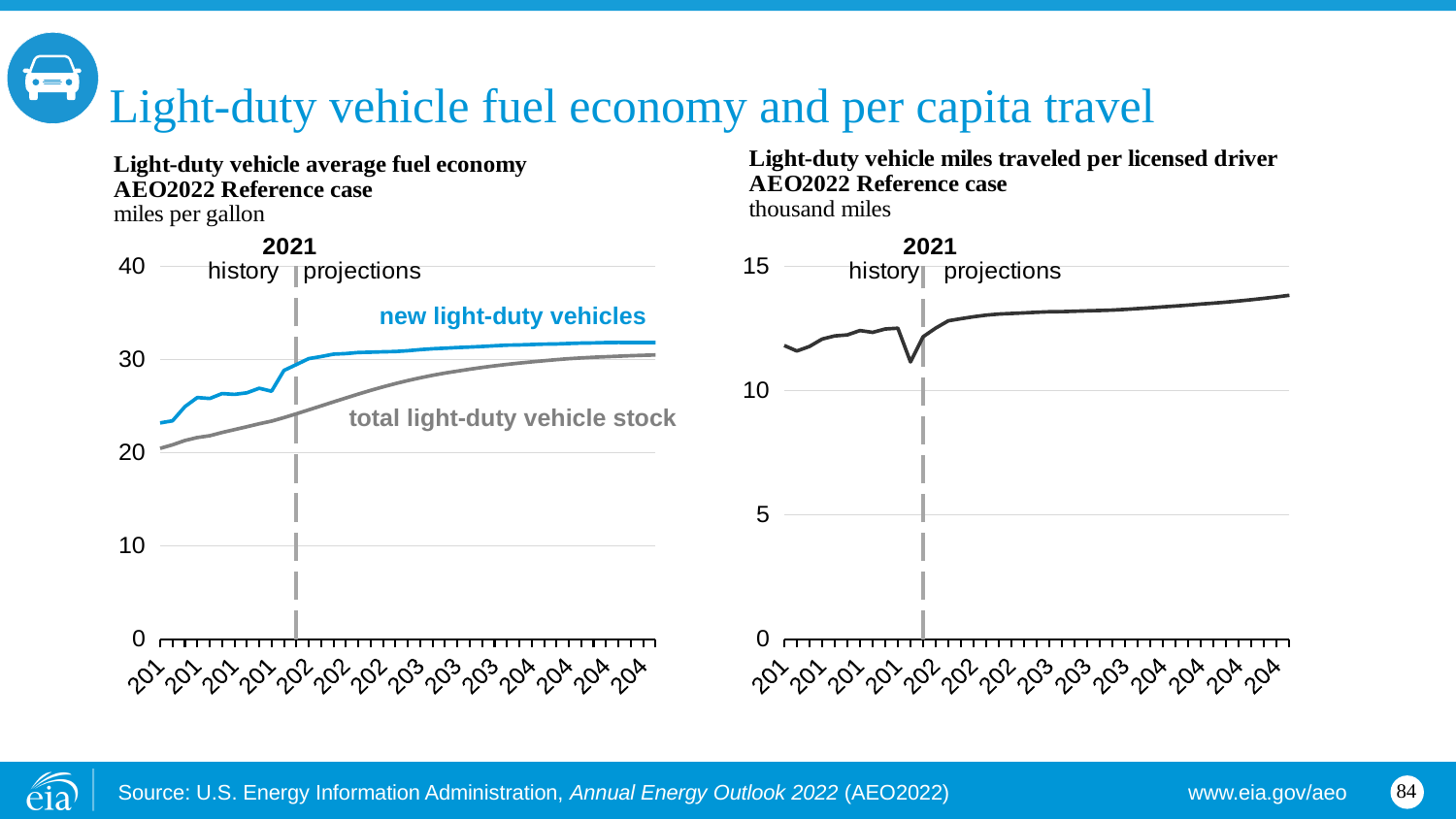
On the left chart, 'Light-duty vehicle average fuel economy', does the total light-duty vehicle stock line rise or fall over the projection period? rise On the left chart, 'Light-duty vehicle average fuel economy', which series is higher in 2021: new light-duty vehicles or total light-duty vehicle stock? new light-duty vehicles On the right chart, 'Light-duty vehicle miles traveled per licensed driver', is the value in 2021 greater or less than 10? greater What unit is shown on the right chart, 'Light-duty vehicle miles traveled per licensed driver'? thousand miles How many series are plotted on the left chart, 'Light-duty vehicle average fuel economy'? 2 What kind of chart is the left chart, 'Light-duty vehicle average fuel economy'? line chart On the left chart, 'Light-duty vehicle average fuel economy', is the value for new light-duty vehicles at the end of the projection period greater or less than 30? greater On the right chart, 'Light-duty vehicle miles traveled per licensed driver', is the value at the end of the projection period greater or less than 15? less What unit is shown on the left chart, 'Light-duty vehicle average fuel economy'? miles per gallon What kind of chart is the right chart, 'Light-duty vehicle miles traveled per licensed driver'? line chart On the right chart, 'Light-duty vehicle miles traveled per licensed driver', do the values rise or fall over the projection period? rise